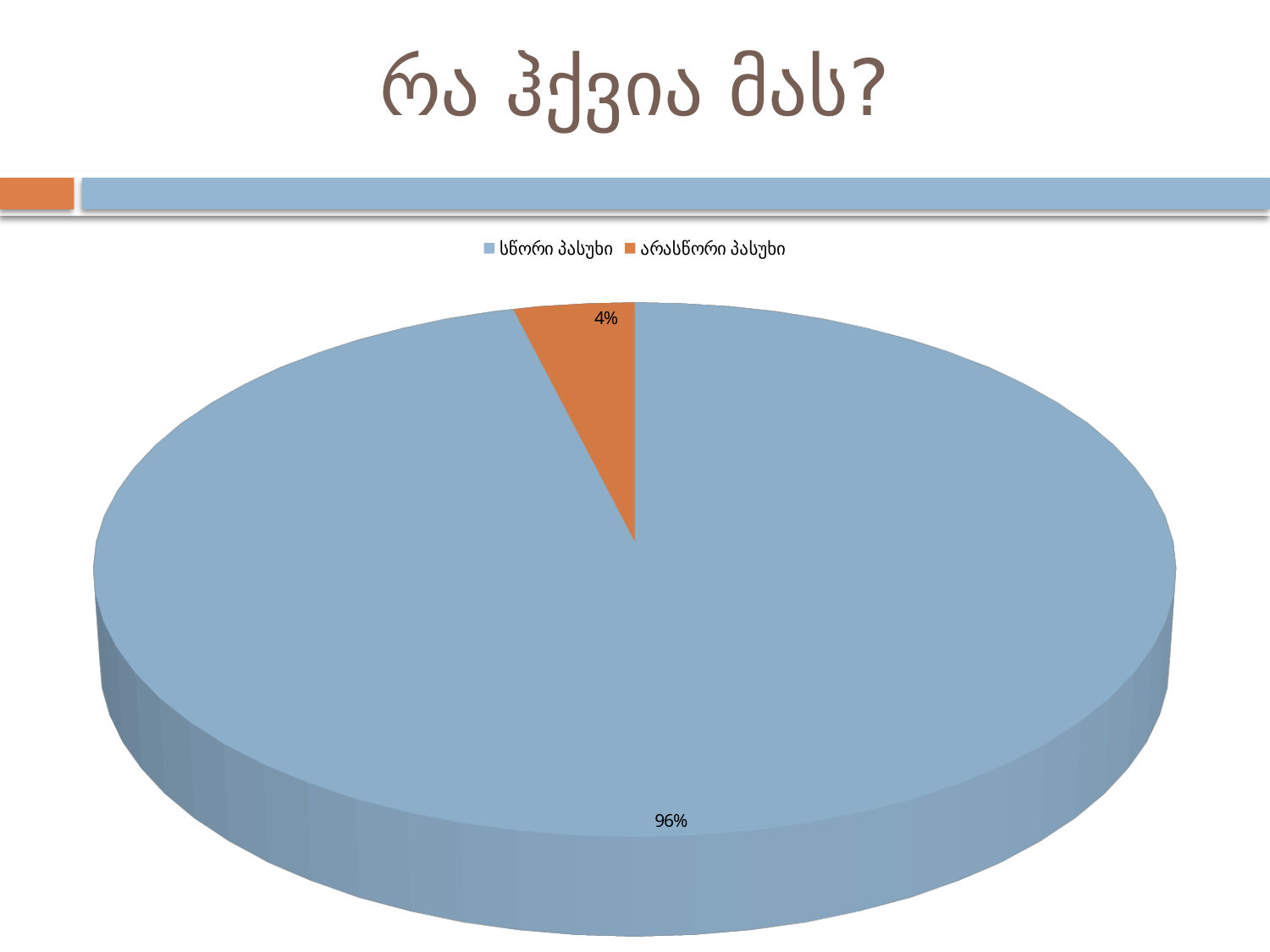
What share of the pie does the "არასწორი პასუხი" slice represent? 4% What is the difference in percentage points between the "სწორი პასუხი" slice and the "არასწორი პასუხი" slice? 92 How many slices does the pie chart have? 2 Which is larger: the "სწორი პასუხი" slice or the "არასწორი პასუხი" slice? სწორი პასუხი What is the title of the slide containing the pie chart? რა ჰქვია მას? What colour is the "არასწორი პასუხი" slice? Orange What kind of chart is shown on the slide? Pie chart How many entries does the legend list? 2 What share of the pie does the "სწორი პასუხი" slice represent? 96% Which slice of the pie is the largest? სწორი პასუხი Which slice of the pie is the smallest? არასწორი პასუხი